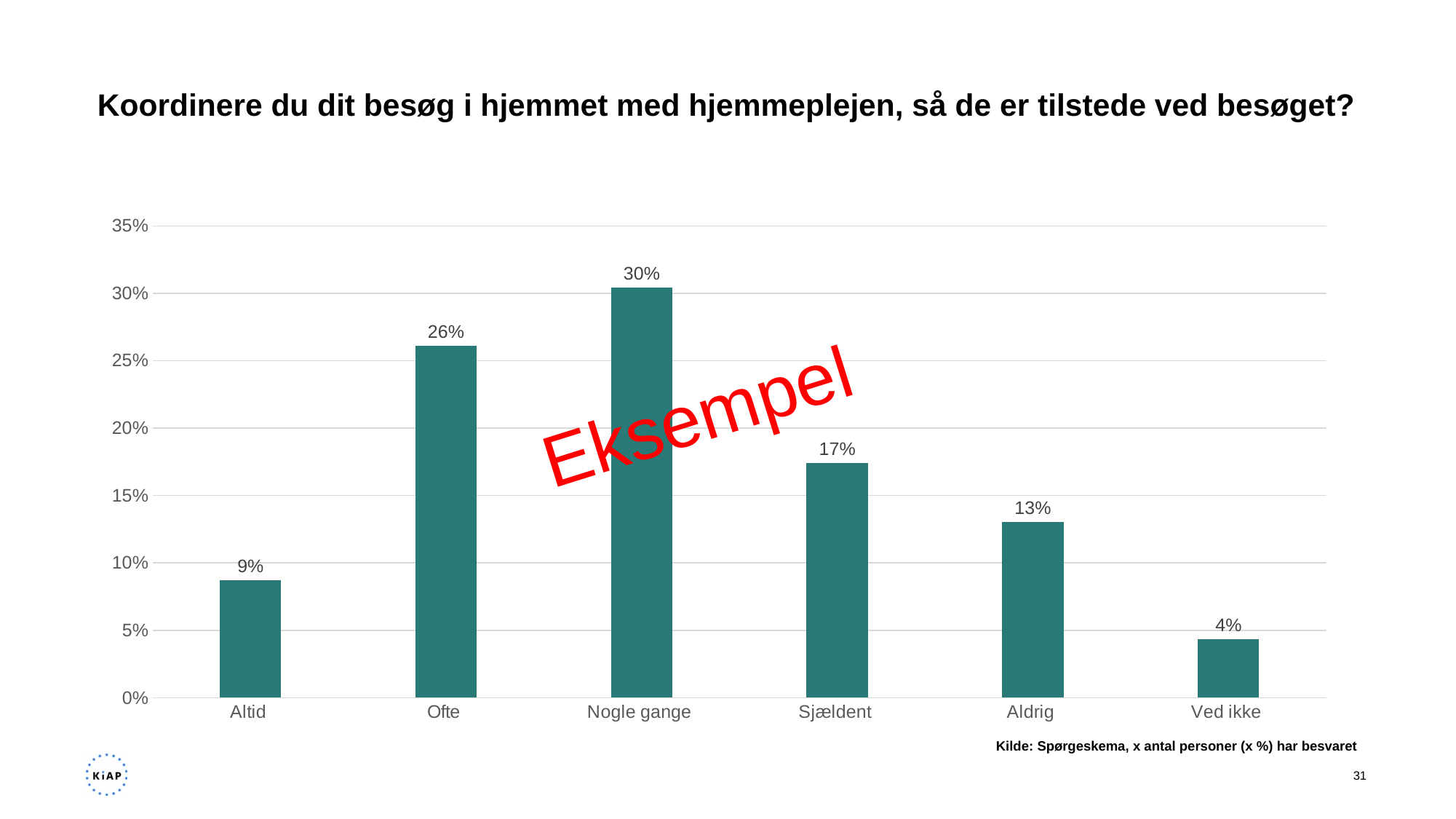
How many categories are shown on the x axis? 6 What is the title of the chart? Koordinere du dit besøg i hjemmet med hjemmeplejen, så de er tilstede ved besøget? What is the difference between the values for Ofte and Sjældent? 9% Is the value for Ofte greater or less than 20%? greater Which category has the highest value? Nogle gange What is the value for Altid? 9% Which is larger, the value for Aldrig or the value for Sjældent? Sjældent What is the value for Ved ikke? 4% What is the difference between the values for Nogle gange and Altid? 21% What kind of chart is shown on the slide? Bar chart What is the value for Nogle gange? 30% Which category has the lowest value? Ved ikke